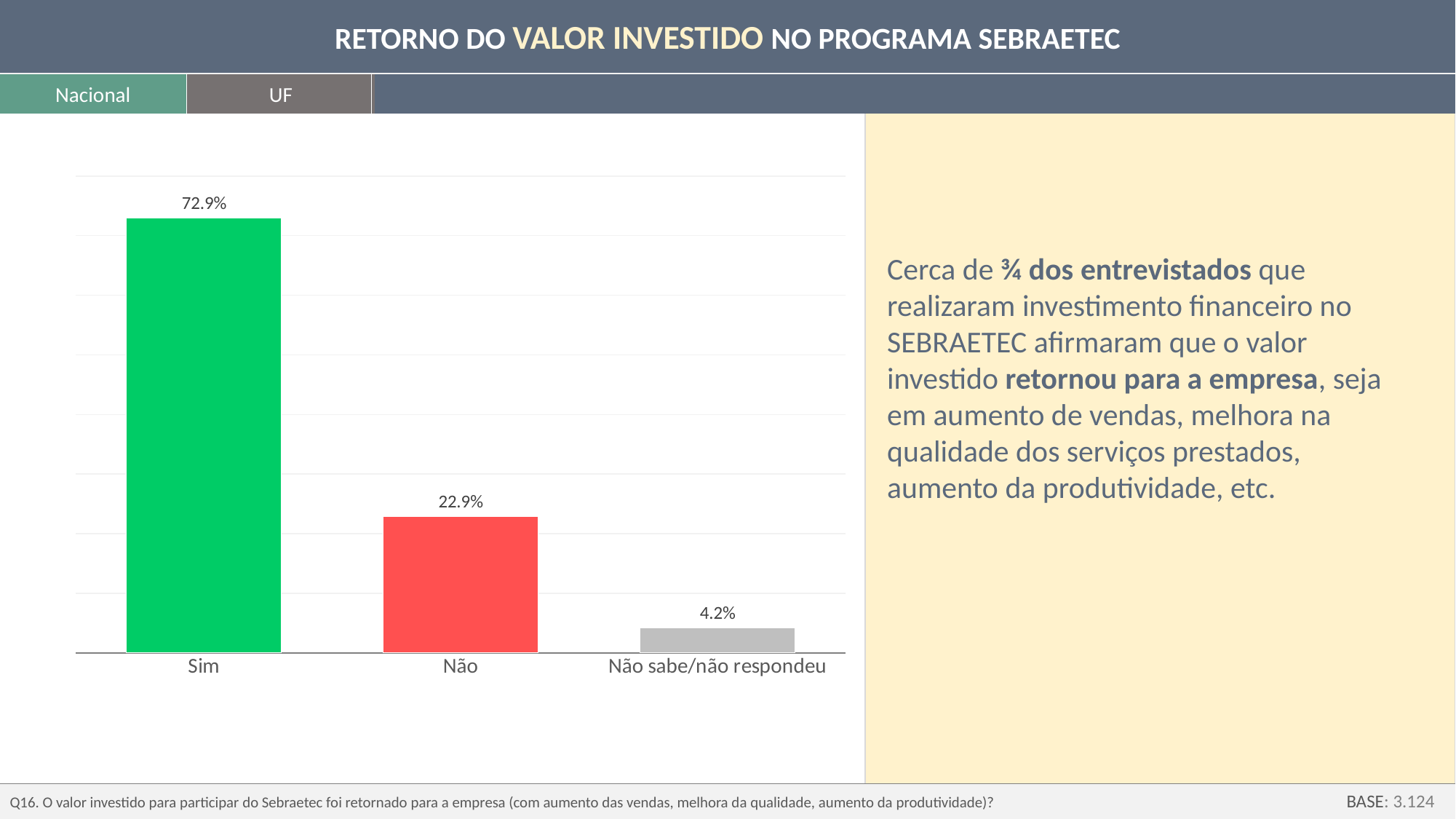
What is the value for Não? 22.9% Do the values rise or fall from left to right across the categories? Fall What is the value for Sim? 72.9% What is the value for Não sabe/não respondeu? 4.2% Which category has the lowest value? Não sabe/não respondeu What is the difference between the values for Sim and Não? 50.0% Which is larger, the value for Não or the value for Não sabe/não respondeu? Não How many categories are shown in the chart? 3 What kind of chart is shown on the slide? Bar chart Which category has the highest value? Sim What is the difference between the values for Não and Não sabe/não respondeu? 18.7% What colour is the bar for Sim? Green